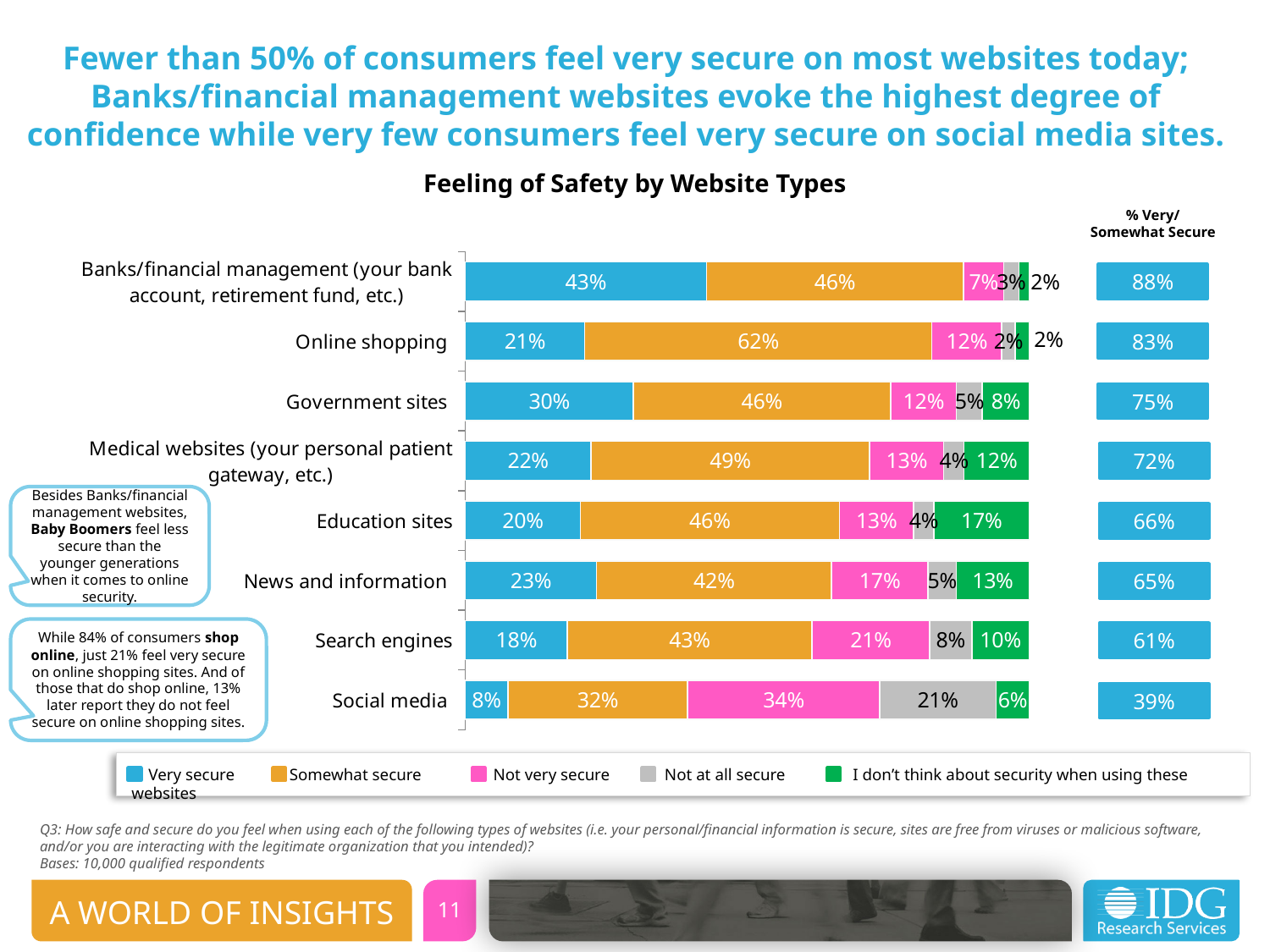
What percentage of consumers feel not very secure on Social media? 34% What percentage of consumers feel somewhat secure on Online shopping sites? 62% What percentage of consumers feel very secure on Banks/financial management websites? 43% Which website type has the highest share of consumers who feel very secure? Banks/financial management (your bank account, retirement fund, etc.) How many website types are shown in the chart? 8 Which has a larger somewhat secure share: Online shopping or Government sites? Online shopping Which website type has the lowest share of consumers who feel very secure? Social media What is the % Very/Somewhat Secure figure shown for Government sites? 75% What is the difference in percentage points between the very secure share for Banks/financial management and for Social media? 35 percentage points How many series does the legend list? 5 What kind of chart is used to show Feeling of Safety by Website Types? Stacked bar chart Which legend entry is shown in green? I don't think about security when using these websites